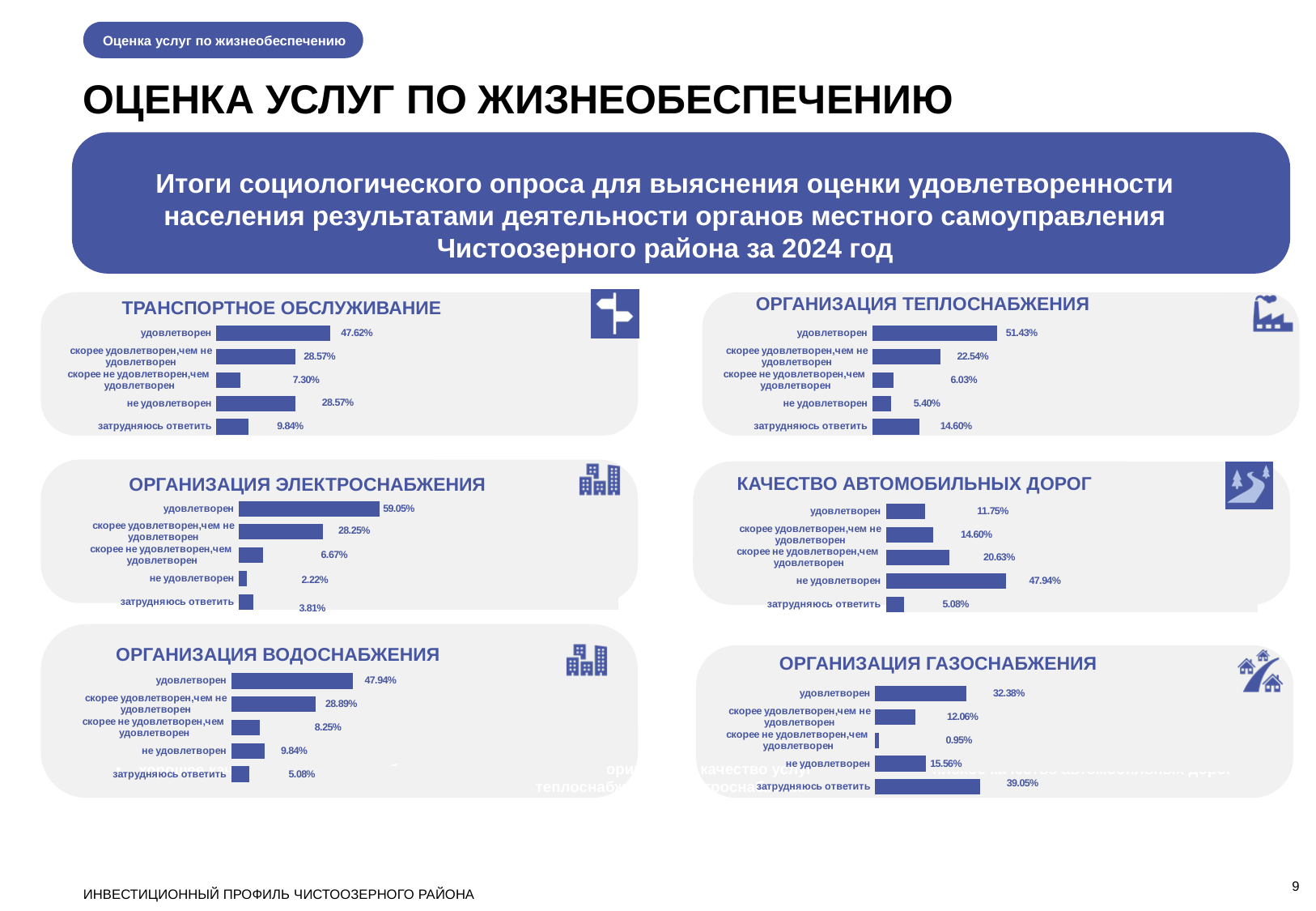
In the chart titled «КАЧЕСТВО АВТОМОБИЛЬНЫХ ДОРОГ», which category has the highest value? не удовлетворен In the chart titled «ОРГАНИЗАЦИЯ ВОДОСНАБЖЕНИЯ», what is the difference between «удовлетворен» and «скорее удовлетворен,чем не удовлетворен»? 19.05% How many bar charts are shown on the slide? 6 What type of chart is used for «КАЧЕСТВО АВТОМОБИЛЬНЫХ ДОРОГ»? Bar chart In the chart titled «ОРГАНИЗАЦИЯ ТЕПЛОСНАБЖЕНИЯ», what is the value for «затрудняюсь ответить»? 14.60% In the chart titled «ОРГАНИЗАЦИЯ ГАЗОСНАБЖЕНИЯ», what is the value for «затрудняюсь ответить»? 39.05% In the chart titled «ОРГАНИЗАЦИЯ ГАЗОСНАБЖЕНИЯ», which category has the lowest value? скорее не удовлетворен,чем удовлетворен In the chart titled «ОРГАНИЗАЦИЯ ЭЛЕКТРОСНАБЖЕНИЯ», what is the value for «не удовлетворен»? 2.22% In the chart titled «ОРГАНИЗАЦИЯ ТЕПЛОСНАБЖЕНИЯ», which is larger: «скорее удовлетворен,чем не удовлетворен» or «затрудняюсь ответить»? скорее удовлетворен,чем не удовлетворен How many categories are shown in the chart titled «ТРАНСПОРТНОЕ ОБСЛУЖИВАНИЕ»? 5 In the chart titled «ОРГАНИЗАЦИЯ ЭЛЕКТРОСНАБЖЕНИЯ», which category has the highest value? удовлетворен In the chart titled «ТРАНСПОРТНОЕ ОБСЛУЖИВАНИЕ», what is the value for «удовлетворен»? 47.62%